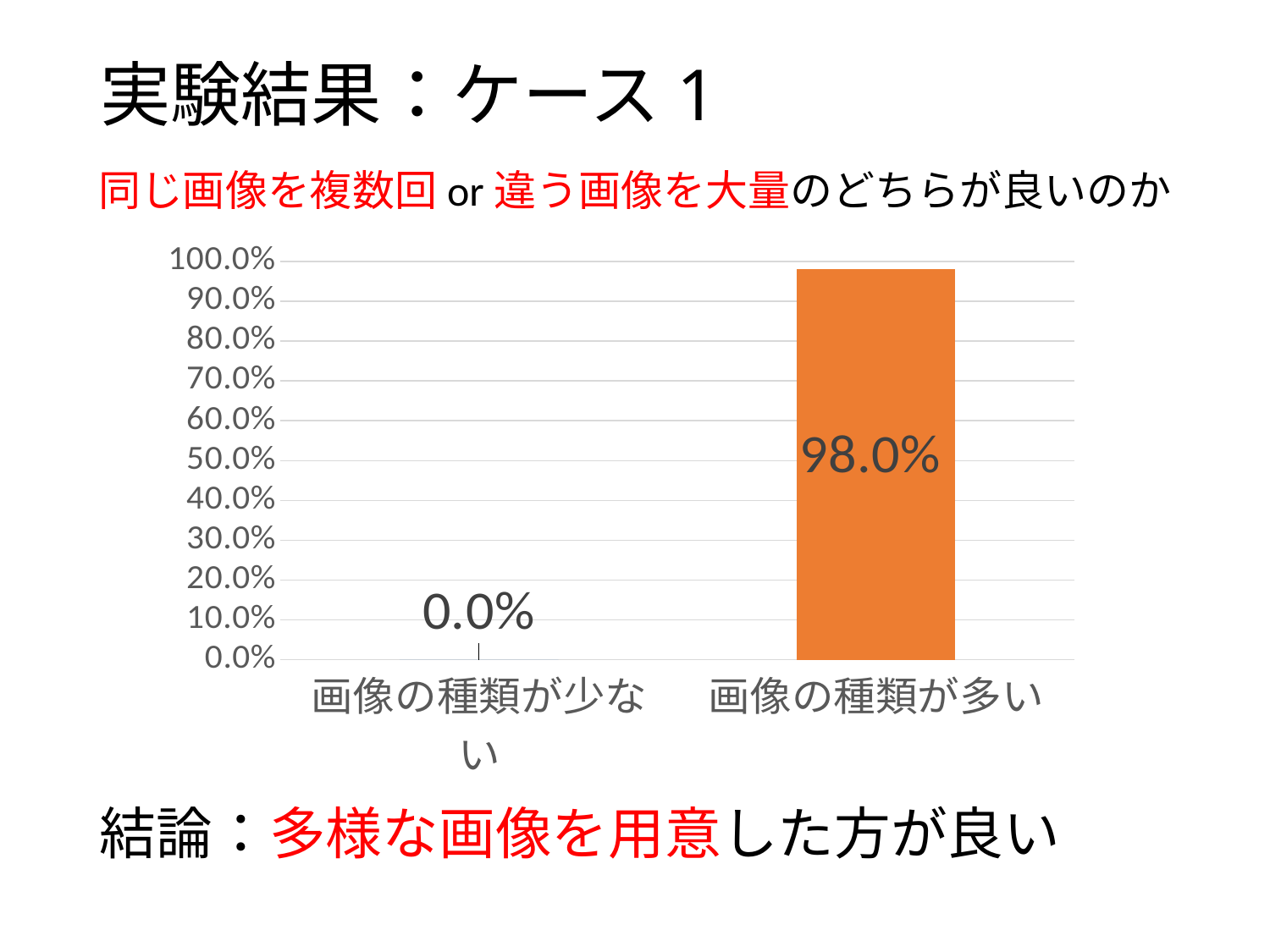
What colour is the bar for 画像の種類が多い? orange What is the maximum value shown on the y axis? 100.0% What is the difference between the values for 画像の種類が多い and 画像の種類が少ない? 98.0% Which is larger, the value for 画像の種類が少ない or the value for 画像の種類が多い? 画像の種類が多い Is the value for 画像の種類が多い greater or less than 90.0%? greater What kind of chart is shown on the slide? bar chart What is the value for 画像の種類が少ない? 0.0% What is the value for 画像の種類が多い? 98.0% Which category has the lowest value? 画像の種類が少ない How many categories are shown on the x axis? 2 Which category has the highest value? 画像の種類が多い Do the values rise or fall from left to right along the x axis? rise